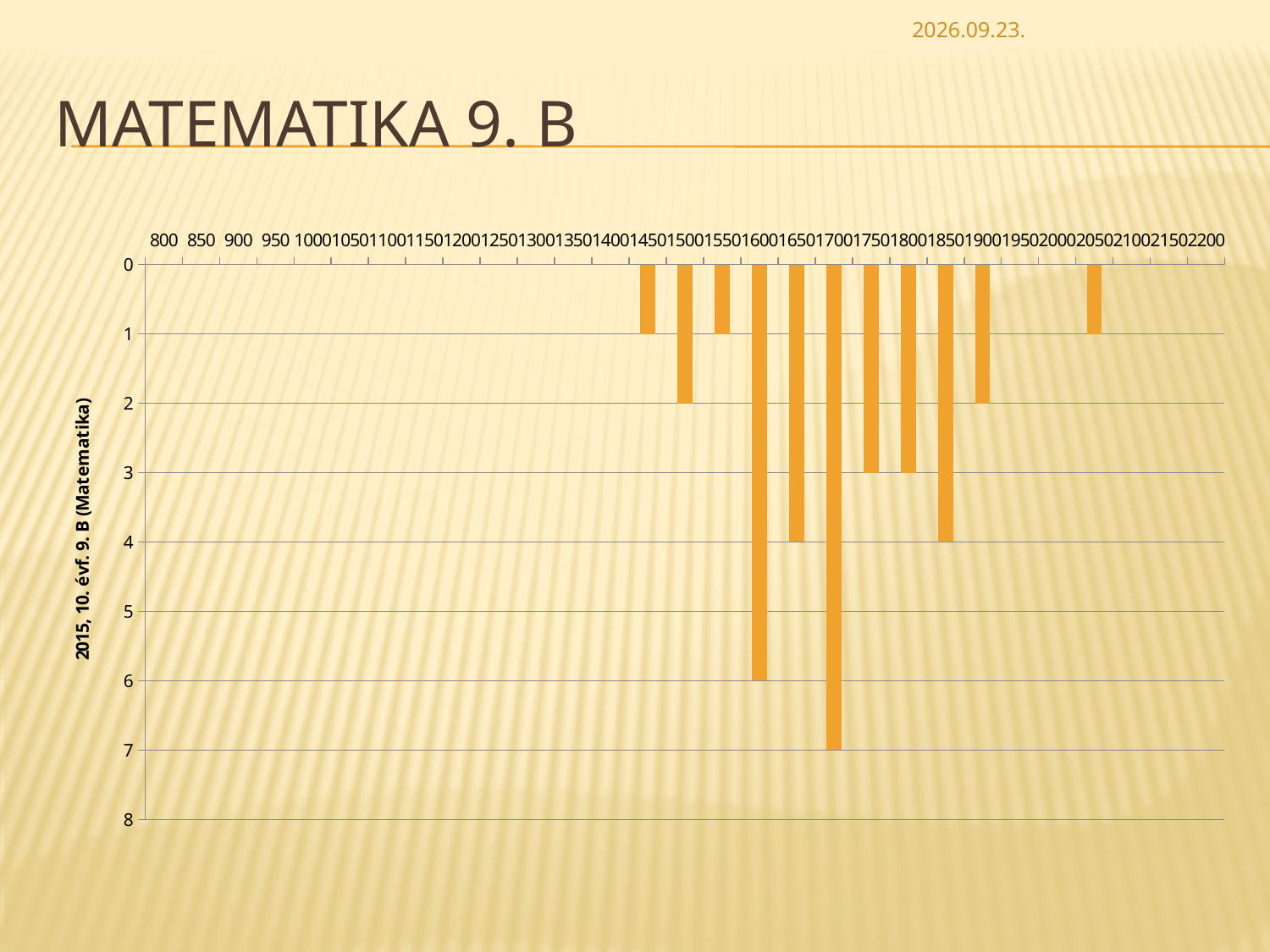
Which bar is larger, the one at 1900 or the one at 1750? 1750 What is the title of the vertical axis? 2015, 10. évf. 9. B (Matematika) Which bar is larger, the one at 1600 or the one at 1650? 1600 What is the difference between the bar at 1650 and the bar at 1500? 2 Which x-axis category has the tallest bar? 1700 What is the value of the bar at 1600? 6 How many bars are plotted in the chart? 11 What is the difference between the bar at 1700 and the bar at 1600? 1 What is the value of the bar at 2050? 1 What is the value of the bar at 1700? 7 What kind of chart is shown on the slide? Bar chart What is the value of the bar at 1850? 4